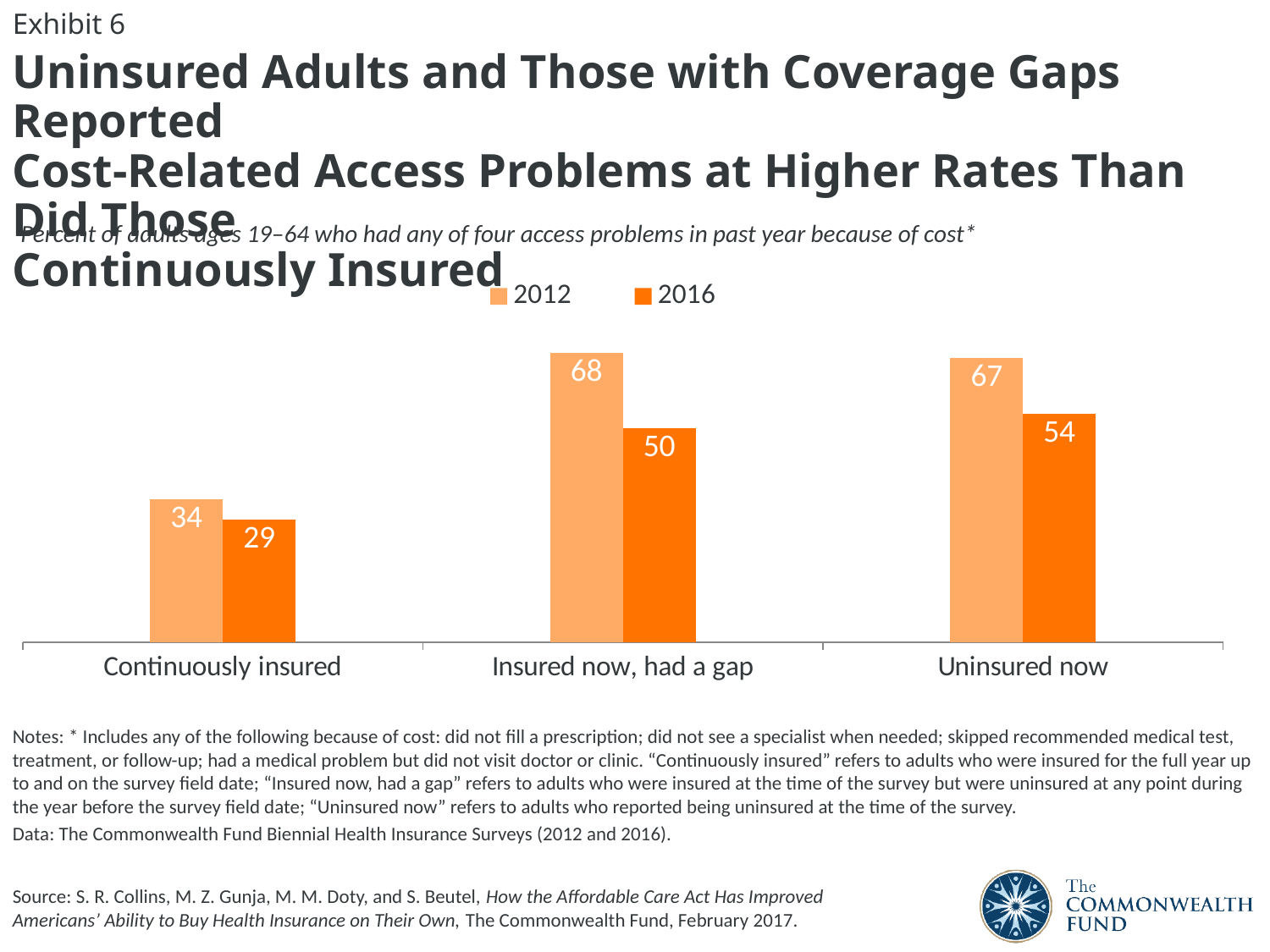
What was the value for 'Continuously insured' in 2016? 29 How many categories are shown on the x axis? 3 Which category had the lowest value in 2016? Continuously insured What was the value for 'Uninsured now' in 2016? 54 Which years are listed in the legend? 2012 and 2016 What is the difference between the 2012 and 2016 values for 'Insured now, had a gap'? 18 Which is larger: the 2016 value for 'Uninsured now' or the 2016 value for 'Insured now, had a gap'? Uninsured now What was the value for 'Insured now, had a gap' in 2012? 68 What is the difference between the 2012 and 2016 values for 'Uninsured now'? 13 How many series does the legend list? 2 What kind of chart is shown on the slide? Bar chart Which category had the highest value in 2012? Insured now, had a gap